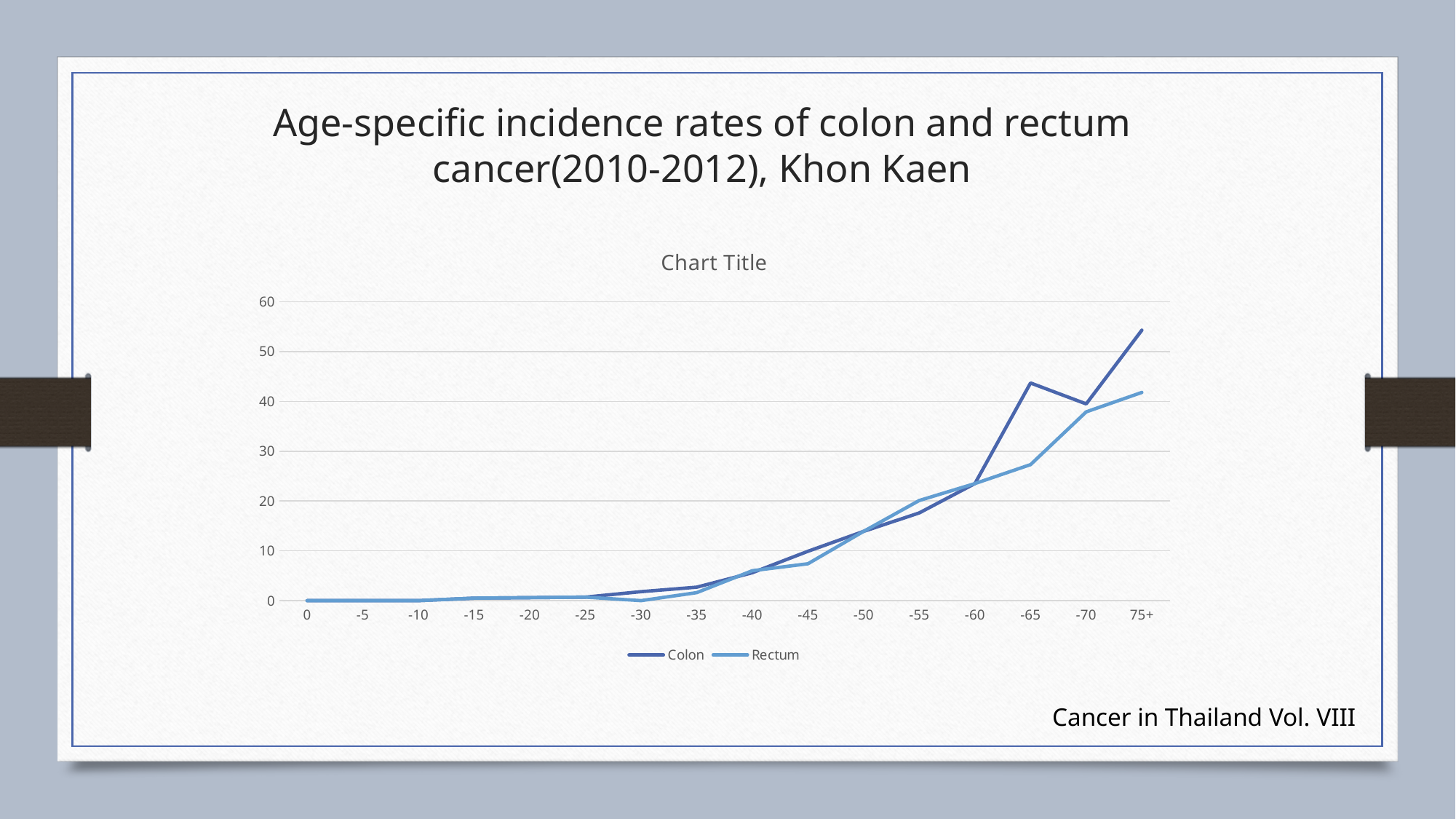
At the -65 age group, which series has the larger value, Colon or Rectum? Colon At which age group does the Colon series reach its highest value? 75+ How many series does the legend list? 2 Is the Rectum value at -65 greater or less than 30? less What are the two series named in the legend? Colon and Rectum How many age-group categories are shown along the x axis? 16 Is the Colon value at -65 greater or less than 40? greater Is the Colon value at 75+ greater or less than 50? greater At which age group does the Rectum series reach its highest value? 75+ Do the incidence rates generally rise or fall as age increases along the x axis? rise What kind of chart is shown on the slide? line chart